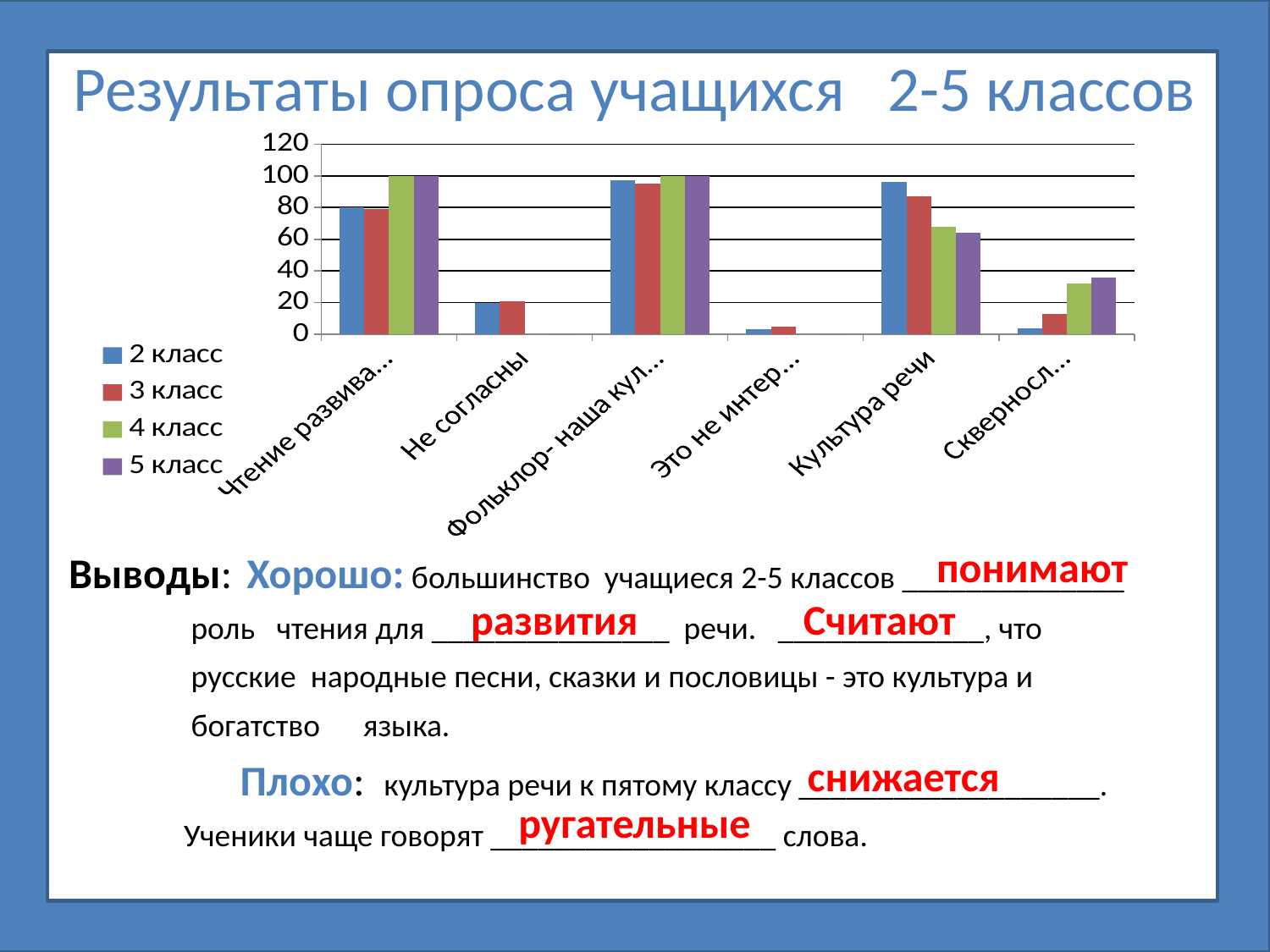
Is the value of "4 класс" for "Культура речи" greater or less than 80? less For the category "Культура речи", do the values rise or fall going from "2 класс" to "5 класс"? fall What is the title of the slide containing the chart? Результаты опроса учащихся 2-5 классов Is the value of "2 класс" for "Не согласны" greater or less than 40? less Is the value of "2 класс" for "Культура речи" greater or less than 80? greater Which series has the highest value for the category "Культура речи"? 2 класс Which colour represents the series "2 класс" in the chart legend? blue How many series does the chart legend list? 4 What kind of chart is shown on the slide? bar chart For the category "Не согласны", which is larger: the value for "2 класс" or for "4 класс"? 2 класс How many categories are shown along the x axis of the chart? 6